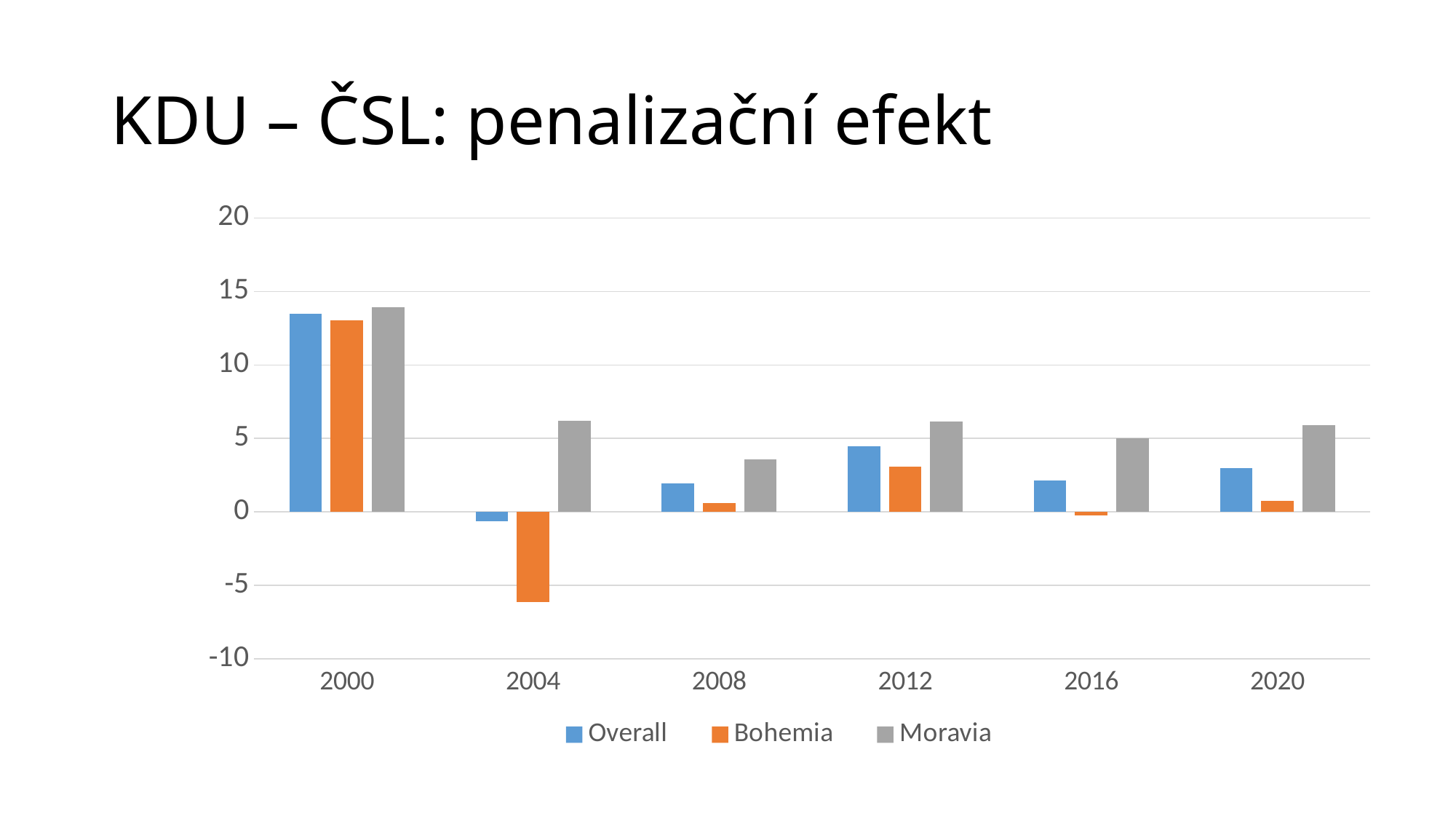
In which year is the Bohemia value lowest? 2004 Is the Overall value for 2000 greater or less than 10? greater Is the Moravia value for 2004 greater or less than 5? greater In which year is the Moravia value highest? 2000 In 2016, which is larger: the Moravia value or the Overall value? Moravia In 2012, which is larger: the Overall value or the Bohemia value? Overall Is the Bohemia value for 2004 greater or less than -5? less How many series does the legend list? 3 What is the title of the slide? KDU – ČSL: penalizační efekt What kind of chart is shown on the slide? bar chart How many years are shown on the x axis? 6